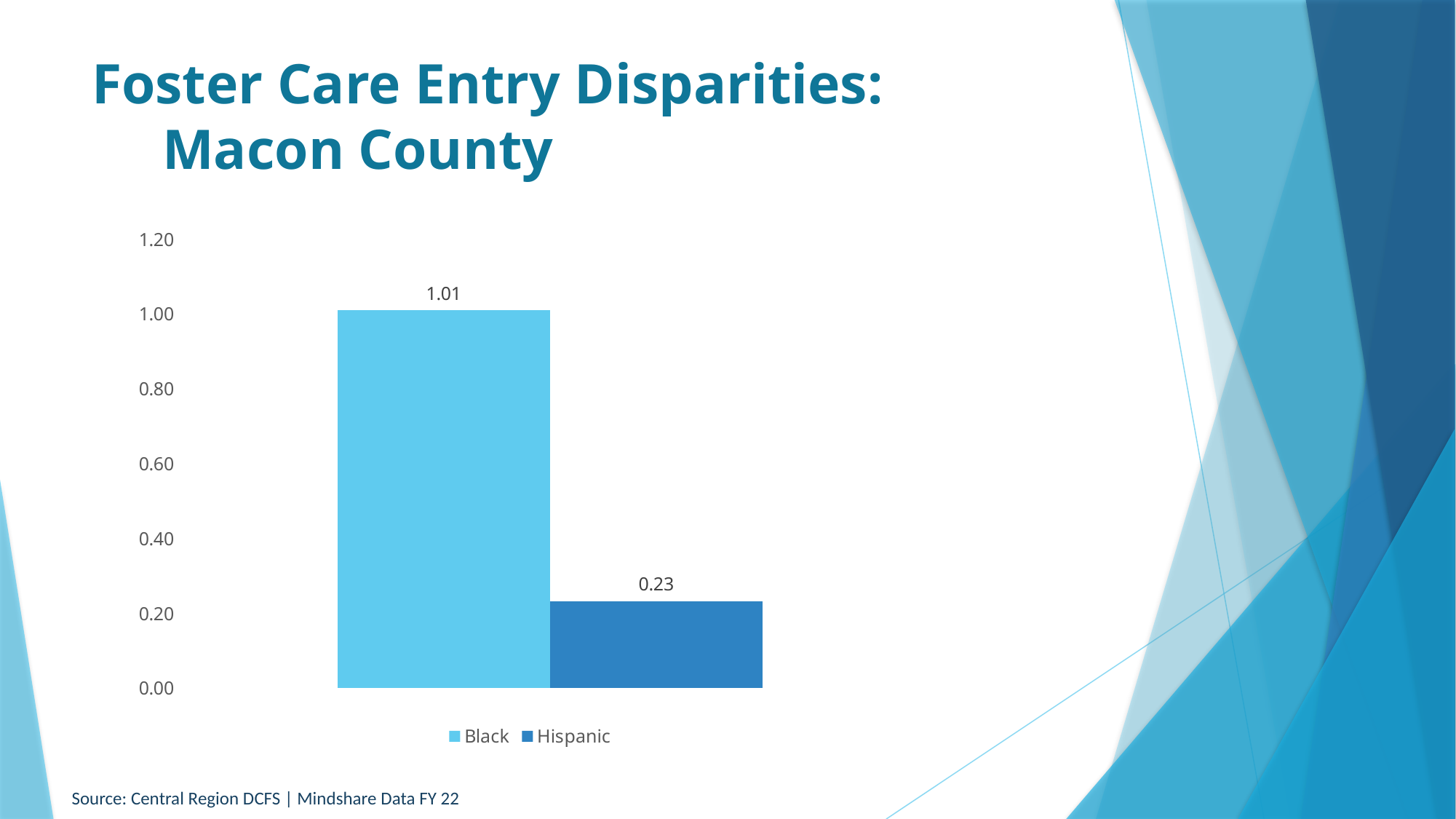
Is the value for Black greater or less than 0.80? greater Which series has the lowest value? Hispanic What is the difference between the Black and Hispanic values? 0.78 What is the value for Hispanic? 0.23 Which is larger, the value for Black or the value for Hispanic? Black What is the title of the slide containing the chart? Foster Care Entry Disparities: Macon County Which series has the highest value? Black What kind of chart is shown on the slide? bar chart How many series does the legend list? 2 What is the highest value shown on the vertical axis? 1.20 What is the value for Black? 1.01 Is the value for Hispanic greater or less than 0.40? less